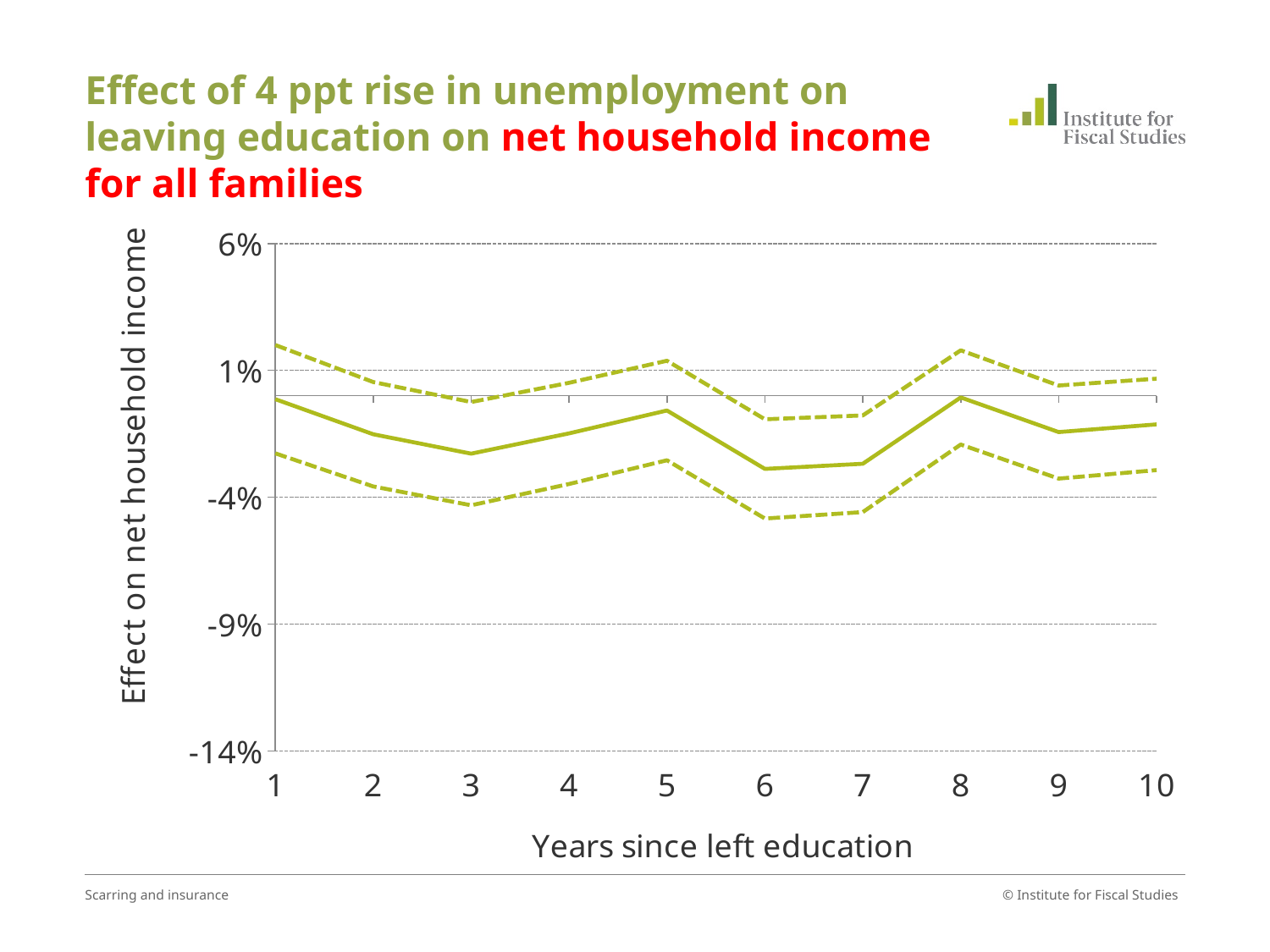
How many years since leaving education are shown on the x axis? 10 On the solid line, is the value at year 5 higher or lower than the value at year 6? higher How many lines are plotted on the chart? 3 Is the value of the lower dashed line at year 6 greater or less than -4%? less Is the value of the upper dashed line at year 8 greater or less than 1%? greater What is the title of the x axis? Years since left education What kind of chart is shown on the slide? line chart Does the solid line rise or fall between year 1 and year 3? fall On the solid line, is the value at year 8 higher or lower than the value at year 9? higher What is the title of the y axis? Effect on net household income Is the value of the solid line at year 3 greater or less than 1%? less